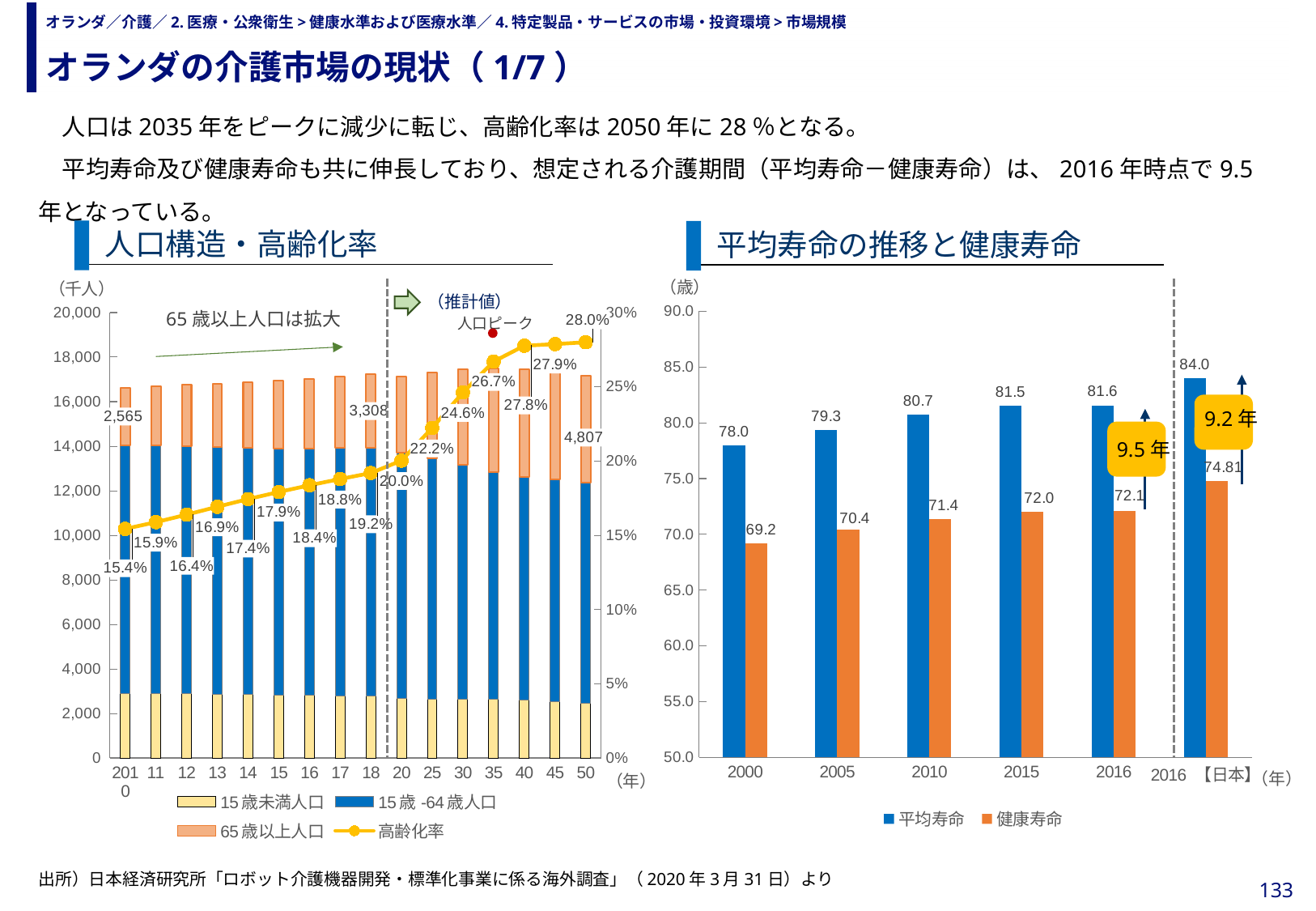
In the chart titled 平均寿命の推移と健康寿命, what is the value of 健康寿命 for 2016【日本】? 74.81 In the chart titled 平均寿命の推移と健康寿命, what is the difference between 平均寿命 and 健康寿命 in 2015? 9.5 In the chart titled 人口構造・高齢化率, what is the 高齢化率 value for 2035? 26.7% In the chart titled 人口構造・高齢化率, is the 15歳未満人口 value for 2010 greater or less than 4,000? less In the chart titled 平均寿命の推移と健康寿命, how many series does the legend list? 2 In the chart titled 平均寿命の推移と健康寿命, does 平均寿命 rise or fall from 2000 to 2016? rise In the chart titled 平均寿命の推移と健康寿命, which category has the lowest 健康寿命 value? 2000 In the chart titled 人口構造・高齢化率, which year has the highest 高齢化率? 2050 In the chart titled 人口構造・高齢化率, what is the 65歳以上人口 value for 2050? 4,807 In the chart titled 平均寿命の推移と健康寿命, what is the value of 平均寿命 for 2010? 80.7 What type of chart is the one titled 平均寿命の推移と健康寿命? bar chart In the chart titled 人口構造・高齢化率, how many series does the legend list? 4